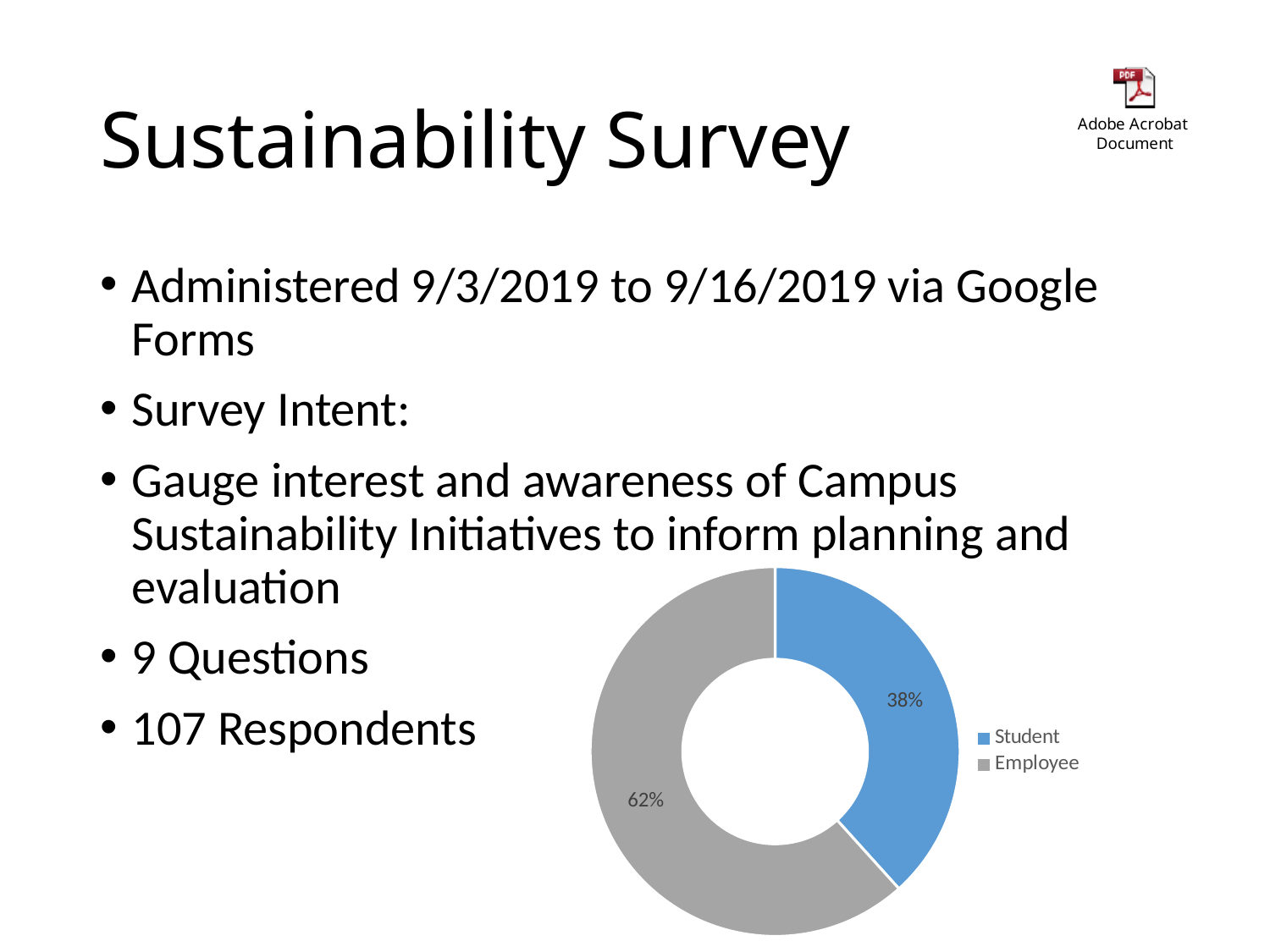
What kind of chart is shown on the slide? Doughnut chart What colour represents Employee in the chart? Gray How many categories does the chart show? 2 What percentage of respondents are Students according to the chart? 38% How many entries does the chart legend list? 2 What is the difference in percentage points between the Employee and Student shares? 24 Is the Student share larger or smaller than the Employee share? Smaller Is the Employee share greater or less than 50%? greater Which category has the larger share of the chart? Employee What colour represents Student in the chart? Blue What percentage of respondents are Employees according to the chart? 62% Which category has the smaller share of the chart? Student